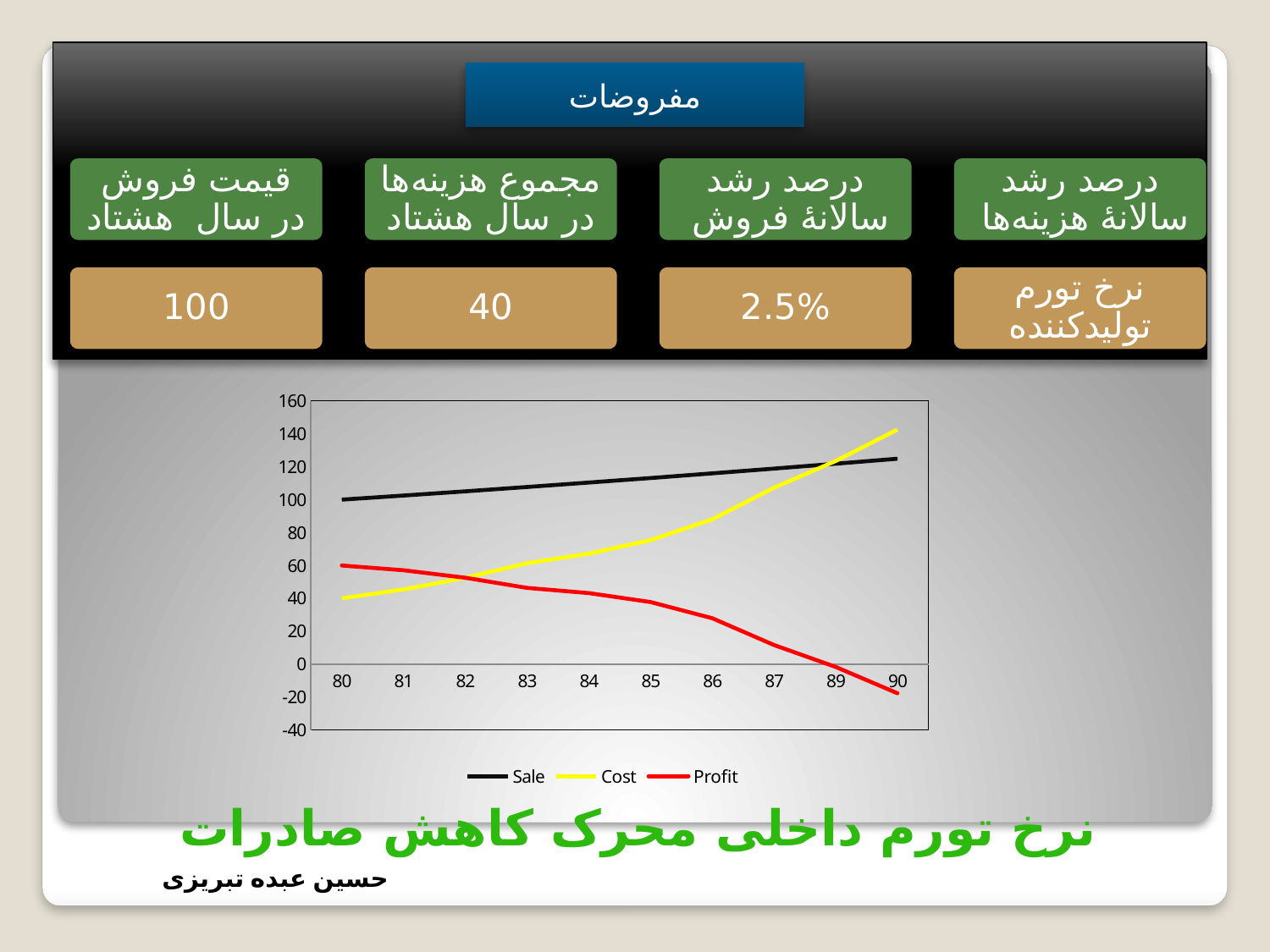
What is the value of Profit at 80? 60 How many series does the chart's legend list? 3 What is the value of Cost at 80? 40 What is the value of Sale at 80? 100 Is the value for Profit at 90 greater or less than 0? less Does the Cost line rise or fall from 80 to 90? rise How many points are plotted along the x axis of the chart? 10 What is the difference between Sale and Cost at 80? 60 Does the Profit line rise or fall from 80 to 90? fall Is the value for Cost at 90 greater or less than 120? greater What kind of chart is shown on the slide? line chart At 90, which is larger, Cost or Sale? Cost